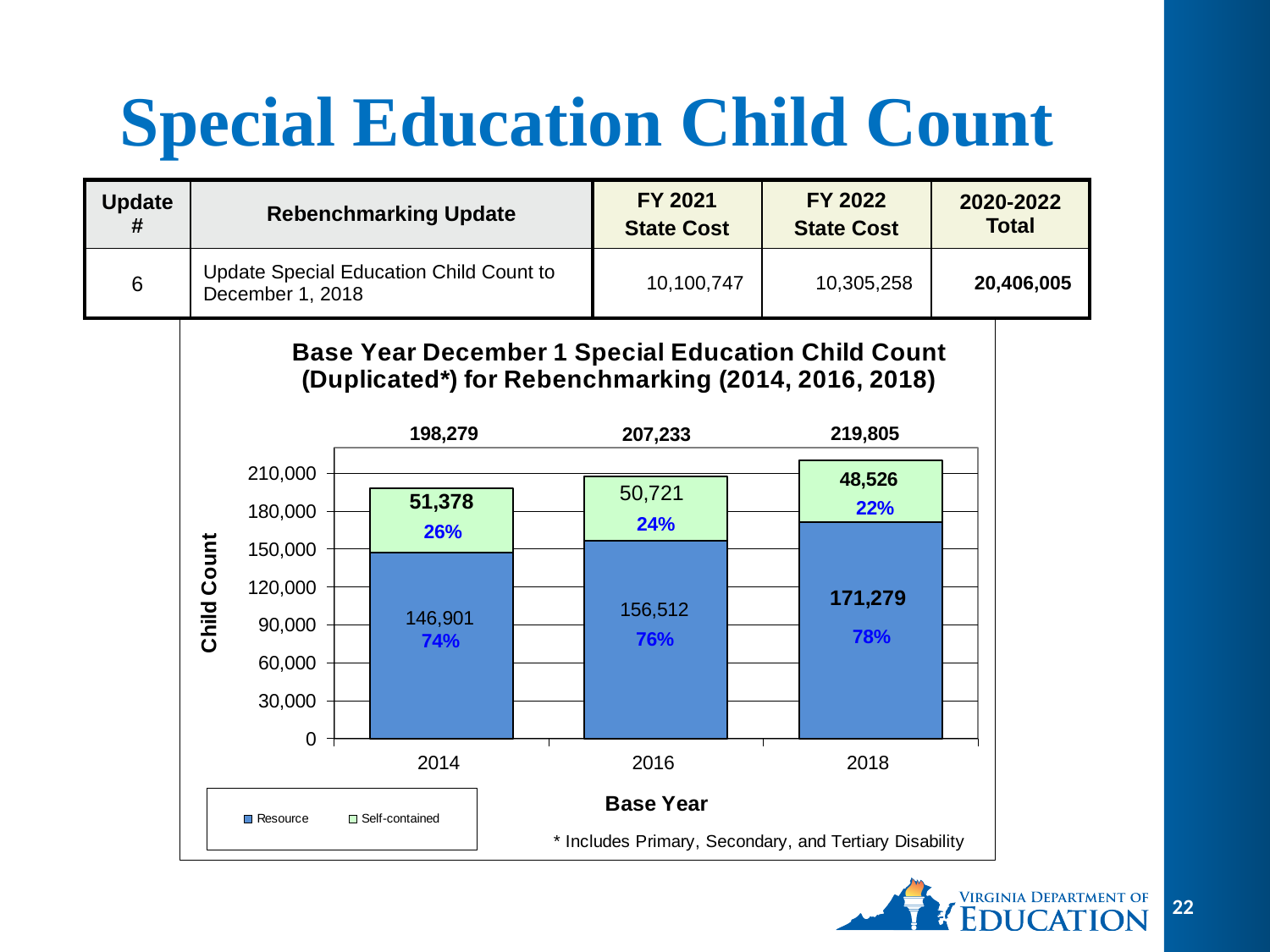
What kind of chart is shown on the slide? Stacked bar chart Does the total child count rise or fall from 2014 to 2018? Rise What is the difference between the Resource child count in 2018 and in 2014? 24,378 Which base year has the highest total child count? 2018 What percentage of the 2014 child count is Resource? 74% What is the Resource child count for 2016? 156,512 How many series does the legend list? 2 What is the Self-contained child count for 2018? 48,526 Which base year has the lowest Resource child count? 2014 How many base years are shown on the x axis? 3 What is the total child count shown above the 2016 bar? 207,233 Is the Self-contained child count larger in 2014 or in 2018? 2014